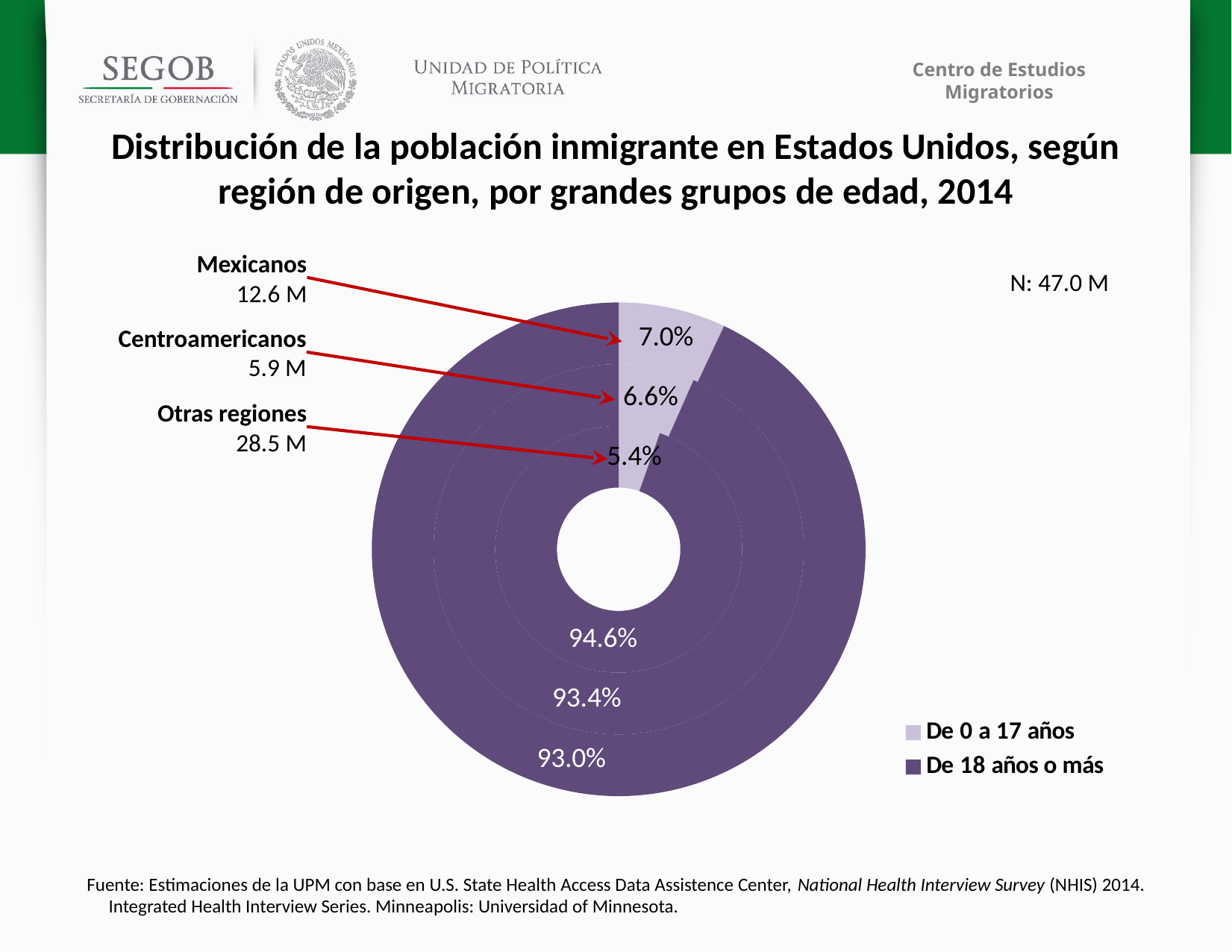
What is the population size shown for Centroamericanos? 5.9 M What is the difference in percentage points between the 0 to 17 years share for Mexicanos and for Otras regiones? 1.6 percentage points What percentage of immigrants from other regions (Otras regiones) are aged 0 to 17 years? 5.4% Which region of origin has the lowest share of immigrants aged 0 to 17 years? Otras regiones What type of chart is shown on the slide? Doughnut chart What percentage of Central American immigrants (Centroamericanos) are aged 18 years or more? 93.4% What is the population size (N) shown for the chart? 47.0 M What percentage of Mexican immigrants (Mexicanos) are aged 0 to 17 years? 7.0% How many series does the legend list? 2 Which is larger: the 18 years or more share for Centroamericanos or for Mexicanos? Centroamericanos Which region of origin has the highest share of immigrants aged 0 to 17 years? Mexicanos What percentage of Mexican immigrants (Mexicanos) are aged 18 years or more? 93.0%